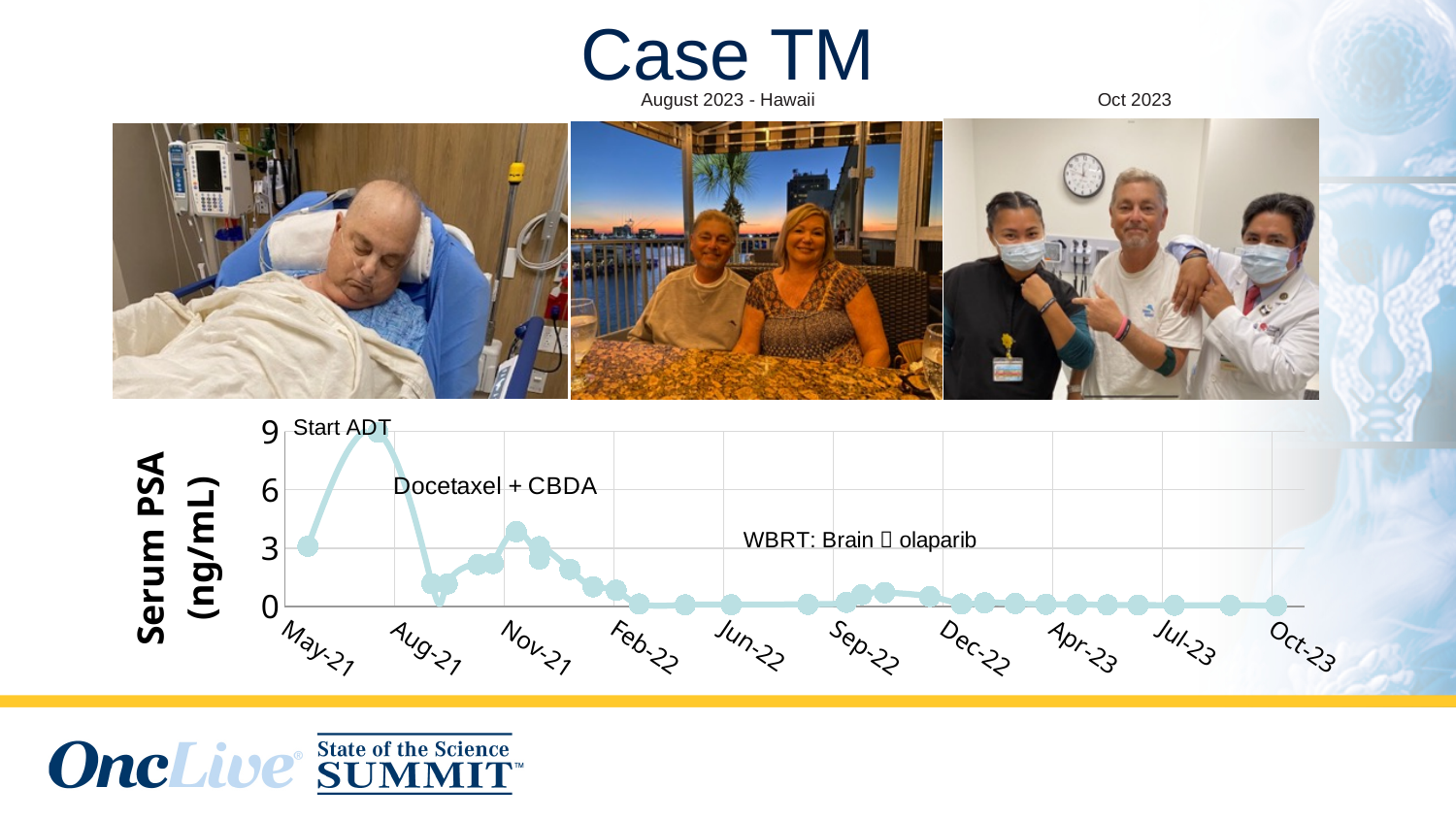
What is the label of the y-axis of the chart? Serum PSA (ng/mL) Is the highest value plotted on the chart greater or less than 6? greater How many date labels are shown on the x-axis of the chart? 10 Is the value for May-21 greater or less than 6? less What kind of chart is shown on the slide? line chart What is the last date label on the x-axis of the chart? Oct-23 Overall, do the values rise or fall from the peak near the start of the chart to Oct-23? fall Which of the two values is larger on the chart: Nov-21 or Jun-22? Nov-21 Is the value for Oct-23 greater or less than 3? less What is the first date label on the x-axis of the chart? May-21 How many lines are plotted on the chart? 1